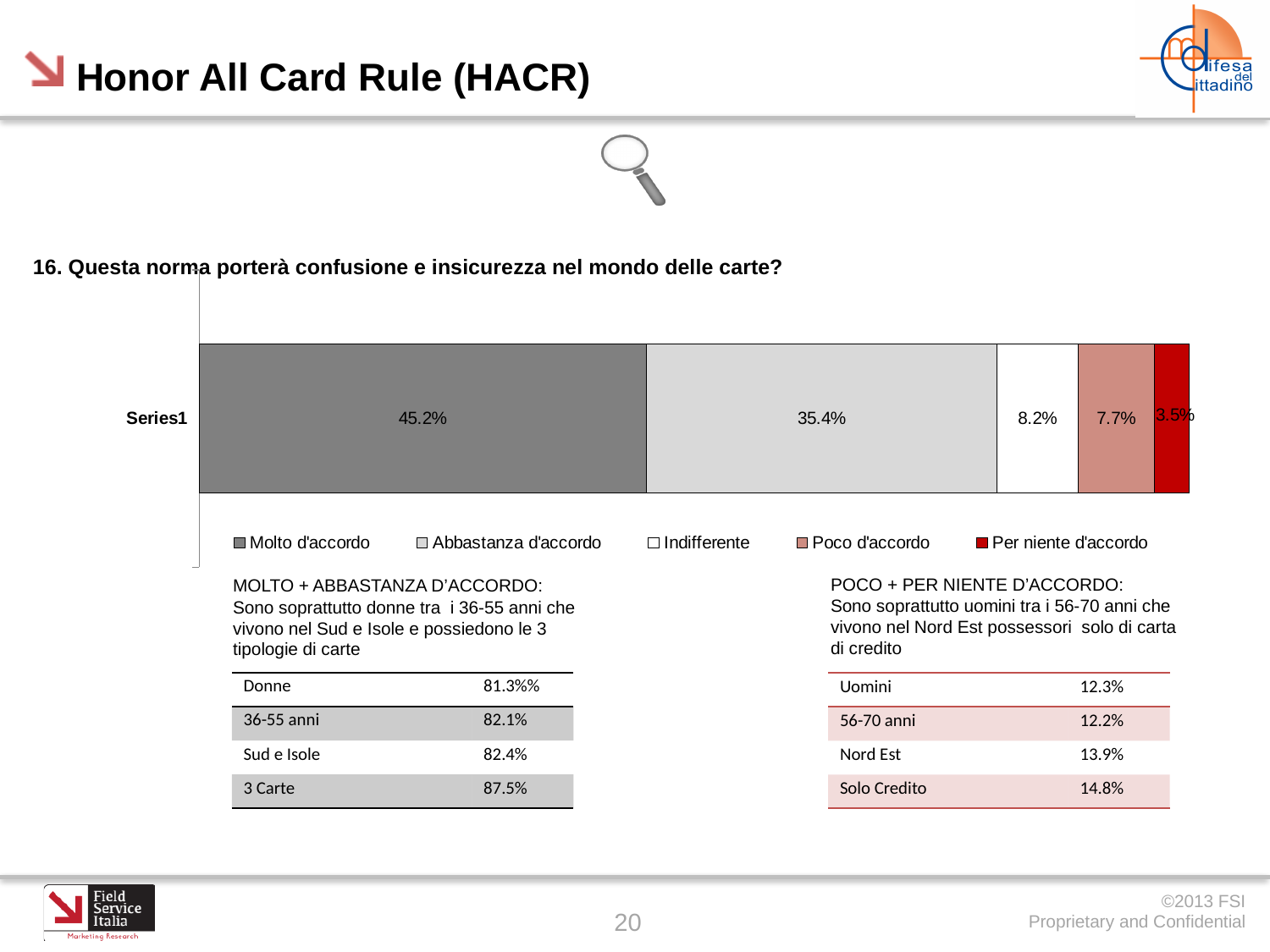
Which response option has the largest share in the bar? Molto d'accordo What is the combined value of "Molto d'accordo" and "Abbastanza d'accordo"? 80.6% What percentage of respondents answered "Molto d'accordo"? 45.2% What is the value shown for "Abbastanza d'accordo"? 35.4% How many series does the legend list? 5 What is the value shown for "Indifferente"? 8.2% What is the value shown for "Per niente d'accordo"? 3.5% Which is larger, the value for "Indifferente" or the value for "Poco d'accordo"? Indifferente What is the value shown for "Poco d'accordo"? 7.7% Which response option has the smallest share in the bar? Per niente d'accordo What kind of chart is shown on the slide? Stacked bar chart What is the difference between the "Molto d'accordo" and "Abbastanza d'accordo" values? 9.8%